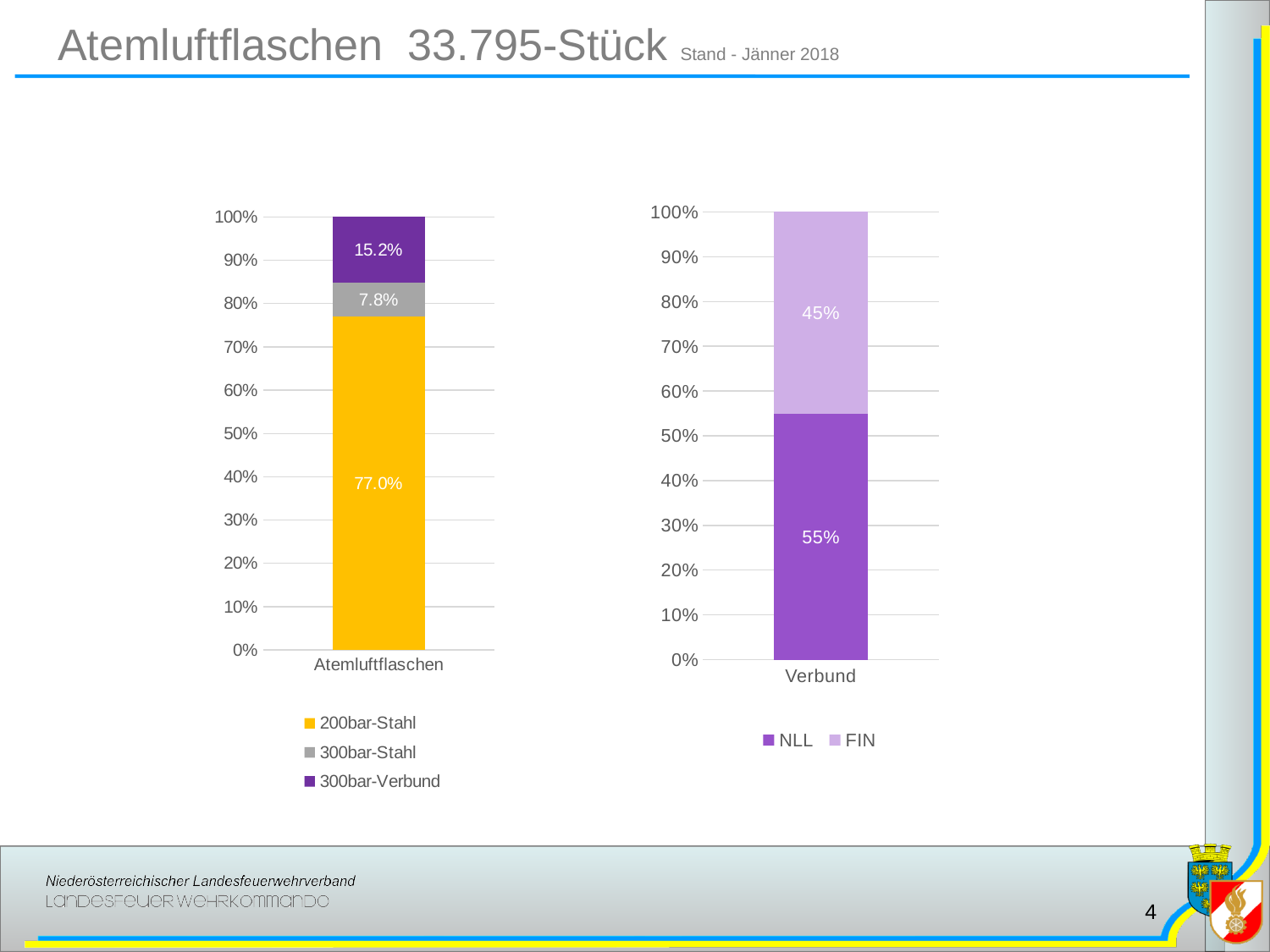
In the right chart (Verbund), which is larger, NLL or FIN? NLL In the left chart (Atemluftflaschen), what is the difference between 300bar-Verbund and 300bar-Stahl? 7.4% In the left chart (Atemluftflaschen), which series has the smallest share? 300bar-Stahl In the left chart (Atemluftflaschen), which series has the largest share? 200bar-Stahl In the left chart (Atemluftflaschen), what is the value for 200bar-Stahl? 77.0% In the left chart (Atemluftflaschen), how many series does the legend list? 3 In the left chart (Atemluftflaschen), what is the value for 300bar-Stahl? 7.8% What kind of chart is the right chart (Verbund)? Stacked bar chart In the right chart (Verbund), what is the value for NLL? 55% In the left chart (Atemluftflaschen), what is the value for 300bar-Verbund? 15.2% In the right chart (Verbund), what is the difference between NLL and FIN? 10% In the right chart (Verbund), what is the value for FIN? 45%